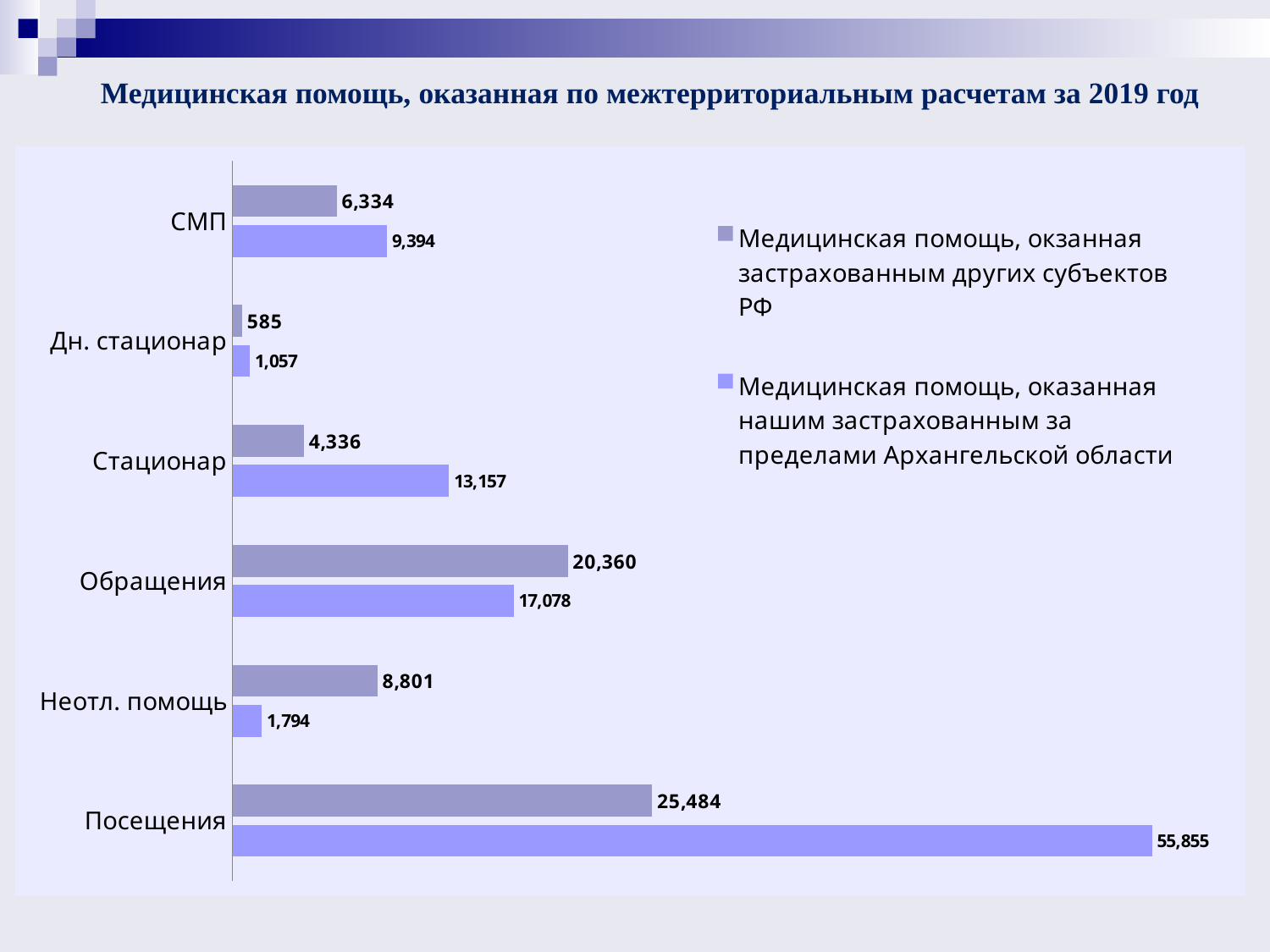
What kind of chart is shown on the slide? Bar chart What is the value for Посещения in the series 'Медицинская помощь, оказанная нашим застрахованным за пределами Архангельской области'? 55,855 What is the value for Обращения in the series 'Медицинская помощь, окзанная застрахованным других субъектов РФ'? 20,360 For Обращения, which series has the larger value? Медицинская помощь, окзанная застрахованным других субъектов РФ How many categories are shown on the chart? 6 What is the value for Дн. стационар in the series 'Медицинская помощь, окзанная застрахованным других субъектов РФ'? 585 Which category has the highest value in the series 'Медицинская помощь, оказанная нашим застрахованным за пределами Архангельской области'? Посещения Which category has the lowest value in the series 'Медицинская помощь, окзанная застрахованным других субъектов РФ'? Дн. стационар What is the value for Неотл. помощь in the series 'Медицинская помощь, оказанная нашим застрахованным за пределами Архангельской области'? 1,794 What is the difference between the two series values for Стационар? 8,821 What is the title of the slide? Медицинская помощь, оказанная по межтерриториальным расчетам за 2019 год How many series does the legend list? 2